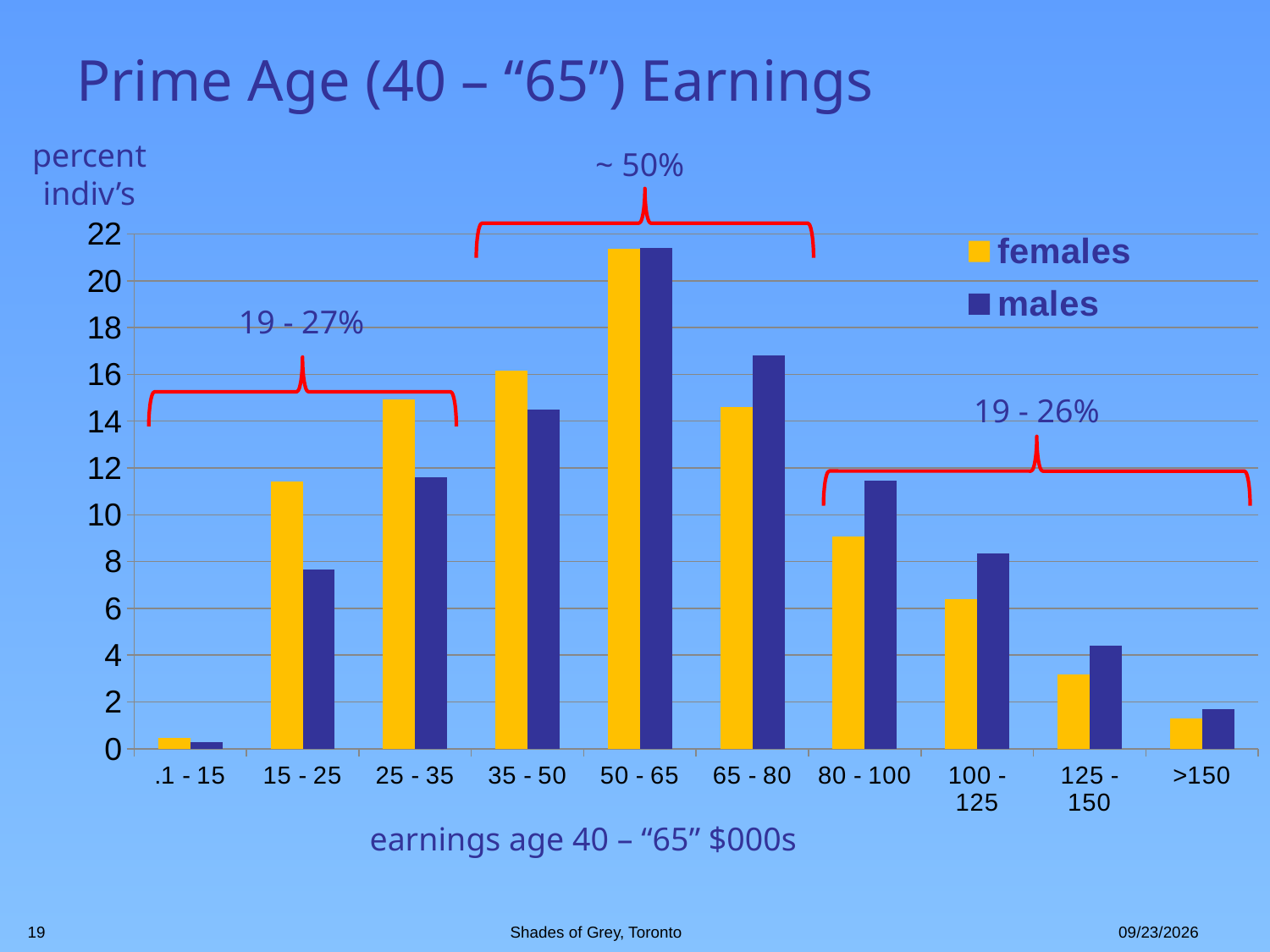
What are the two entries in the chart's legend? females, males What kind of chart is shown on the slide? bar chart Which earnings category has the lowest value for males? .1 - 15 Is the value for males in the 15 - 25 category greater or less than 10? less Which earnings category has the highest value for females? 50 - 65 How many earnings categories are shown on the x axis? 10 Is the value for males in the 80 - 100 category greater or less than 10? greater Is the value for females in the 35 - 50 category greater or less than 14? greater In the 15 - 25 category, which is larger, the value for females or for males? females How many series does the legend list? 2 In the 65 - 80 category, which is larger, the value for females or for males? males Do the values for males rise or fall from the 50 - 65 category to the >150 category? fall